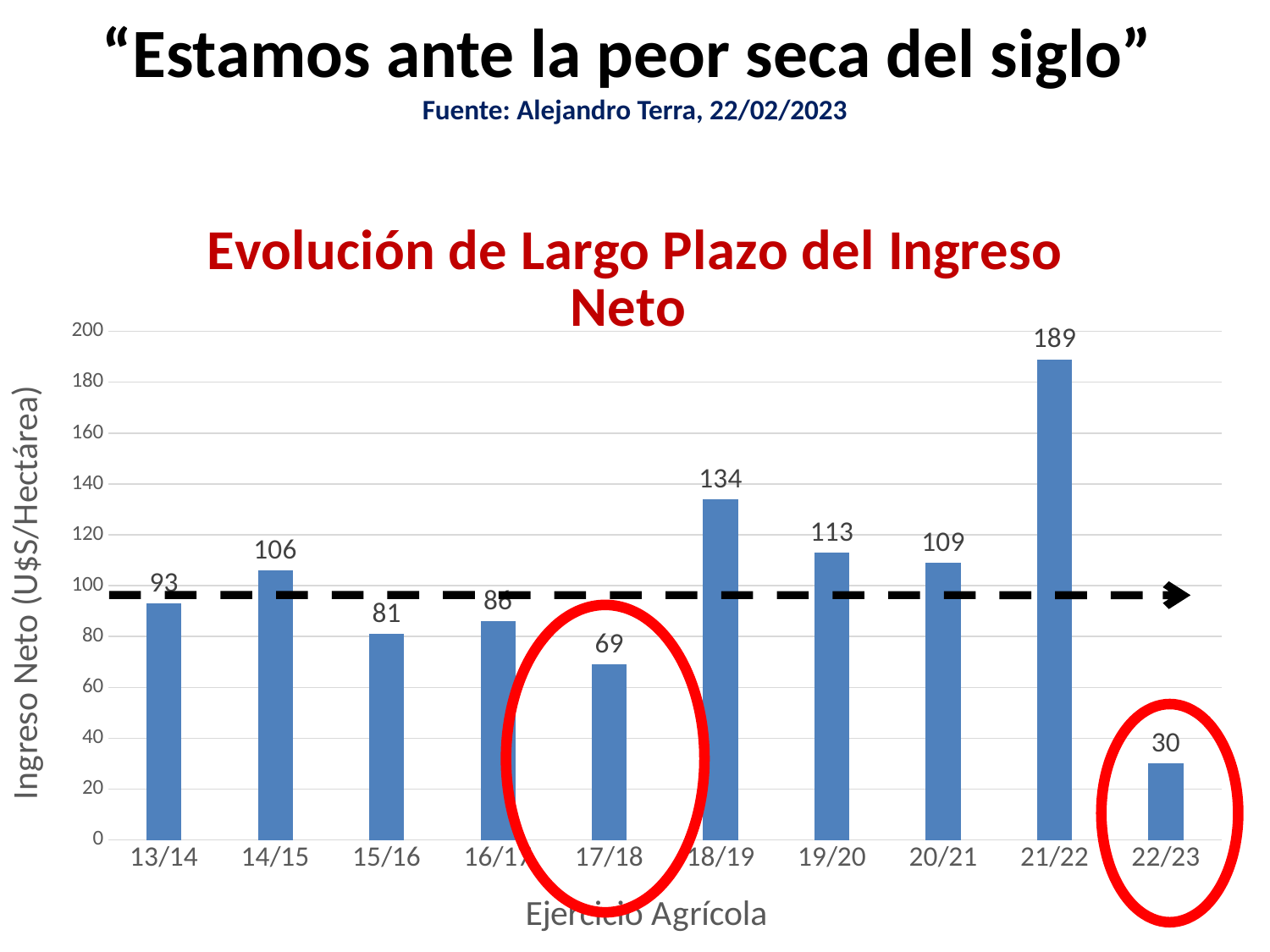
What is the label of the y axis? Ingreso Neto (U$S/Hectárea) What is the value for 21/22? 189 Which category has the highest value? 21/22 How many categories are shown on the x axis? 10 Which is larger, the value for 19/20 or the value for 20/21? 19/20 Which category has the lowest value? 22/23 What is the value for 22/23? 30 What is the difference between the values for 21/22 and 22/23? 159 What is the title of the chart? Evolución de Largo Plazo del Ingreso Neto What type of chart is shown on the slide? bar chart What is the value for 17/18? 69 What is the value for 18/19? 134